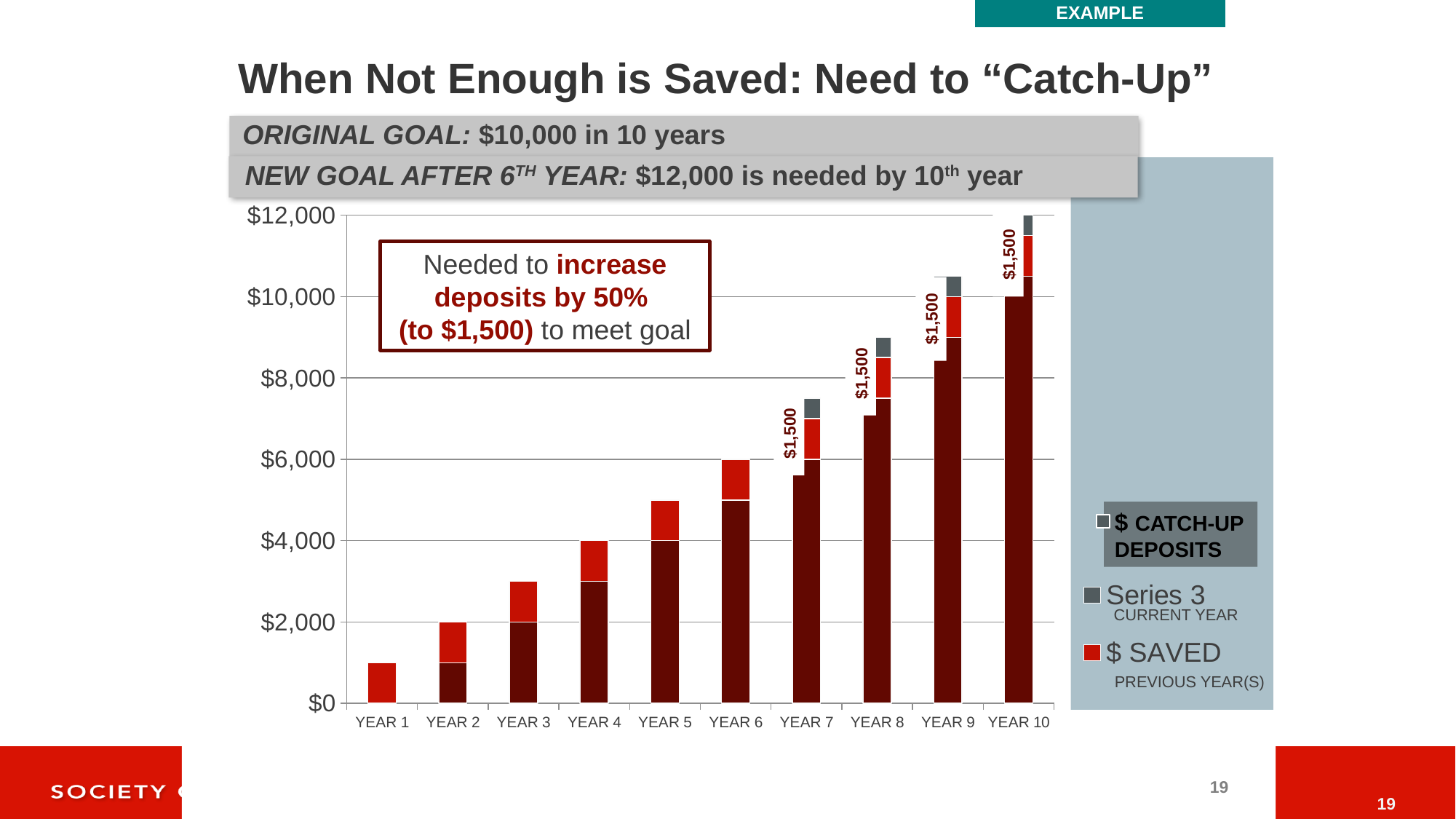
What kind of chart is shown on the slide? bar chart What is the total height of the Year 6 stacked bar? $6,000 What value is printed as the data label on the Year 10 bar? $1,500 Is the total height of the Year 1 bar greater or less than $2,000? less Which year has the tallest stacked bar? Year 10 Is the total height of the Year 9 bar greater or less than $10,000? greater Which year has the shortest stacked bar? Year 1 Which bar is taller, Year 8 or Year 4? Year 8 Do the stacked bar totals rise or fall from Year 1 to Year 10? rise How many series does the legend list? 3 What value is printed as the data label on the Year 7 bar? $1,500 How many years (categories) are shown on the x axis? 10